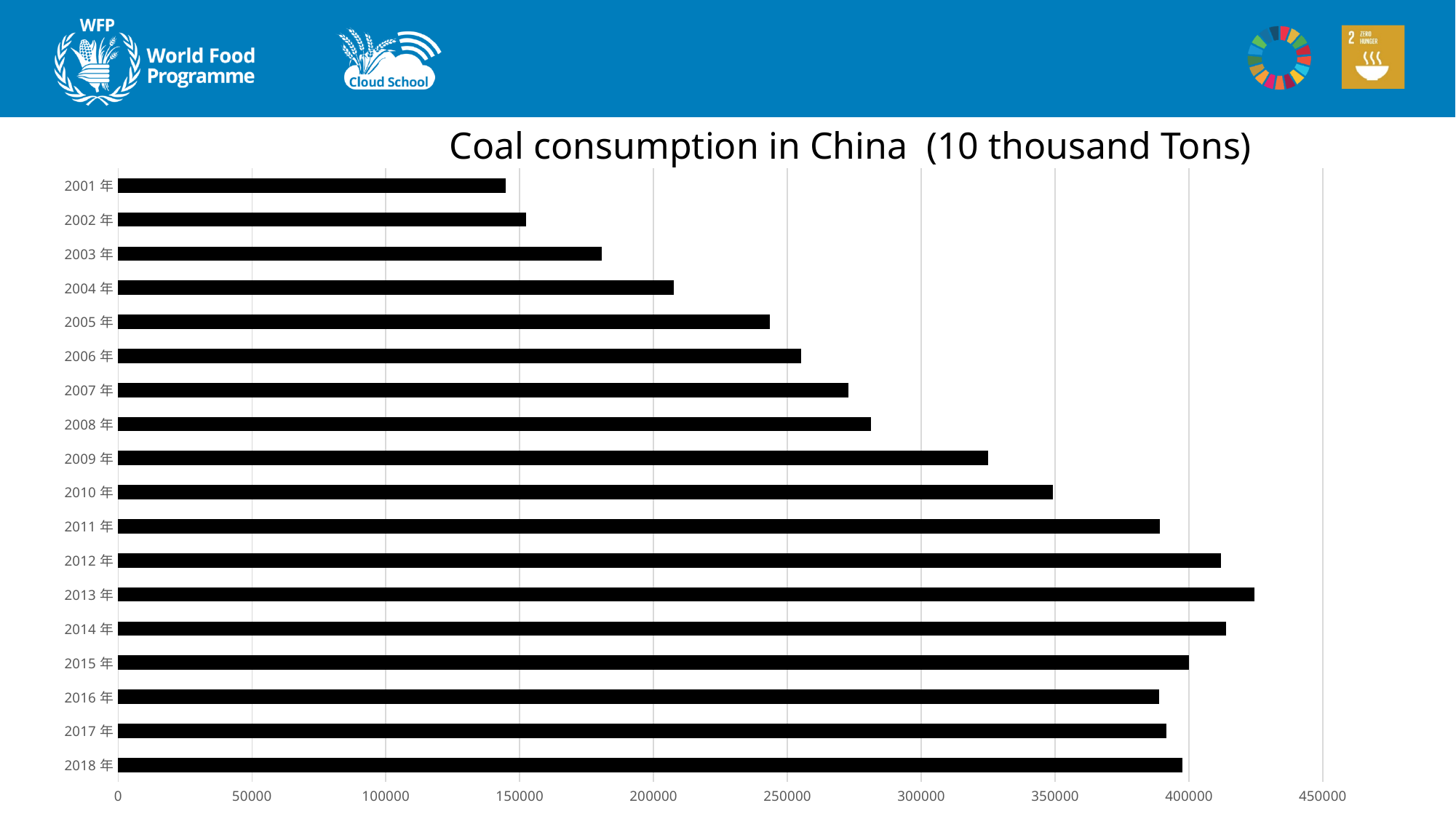
Is the value for 2004 greater or less than 200000? greater Which year has the larger coal consumption, 2002 or 2003? 2003 Which year has the lowest coal consumption? 2001 How many years are plotted in the chart? 18 Is the value for 2013 greater or less than 400000? greater Which year has the larger coal consumption, 2014 or 2015? 2014 Is the value for 2009 greater or less than 300000? greater What is the title of the chart? Coal consumption in China (10 thousand Tons) Do the values generally rise or fall from 2001 to 2013? Rise Which year has the highest coal consumption? 2013 What kind of chart is shown on the slide? Bar chart